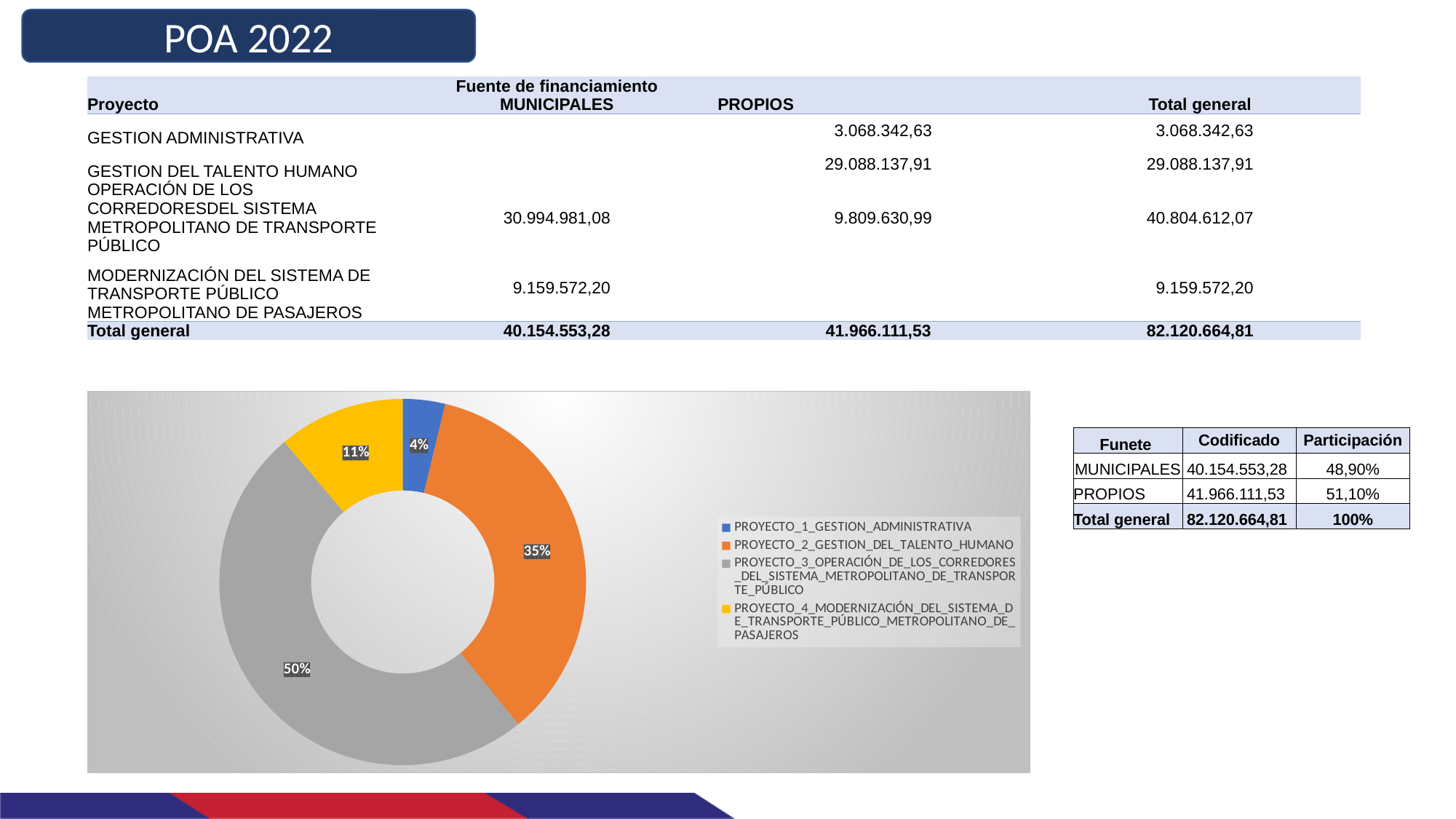
What is the difference in percentage points between the PROYECTO_3 slice and the PROYECTO_2 slice? 15 percentage points How many entries does the legend of the doughnut chart list? 4 What share of the doughnut chart does PROYECTO_1_GESTION_ADMINISTRATIVA represent? 4% Which project has the smallest slice in the doughnut chart? PROYECTO_1_GESTION_ADMINISTRATIVA What percentage is shown for PROYECTO_3_OPERACIÓN_DE_LOS_CORREDORES_DEL_SISTEMA_METROPOLITANO_DE_TRANSPORTE_PÚBLICO in the doughnut chart? 50% How many slices does the doughnut chart have? 4 What share of the doughnut chart does PROYECTO_2_GESTION_DEL_TALENTO_HUMANO represent? 35% What percentage is shown for PROYECTO_4_MODERNIZACIÓN_DEL_SISTEMA_DE_TRANSPORTE_PÚBLICO_METROPOLITANO_DE_PASAJEROS in the doughnut chart? 11% Which project has the largest slice in the doughnut chart? PROYECTO_3_OPERACIÓN_DE_LOS_CORREDORES_DEL_SISTEMA_METROPOLITANO_DE_TRANSPORTE_PÚBLICO Which slice is larger in the doughnut chart: PROYECTO_4 or PROYECTO_1? PROYECTO_4 What kind of chart is shown on the slide? Doughnut (pie) chart What colour is the slice for PROYECTO_2_GESTION_DEL_TALENTO_HUMANO in the doughnut chart? Orange